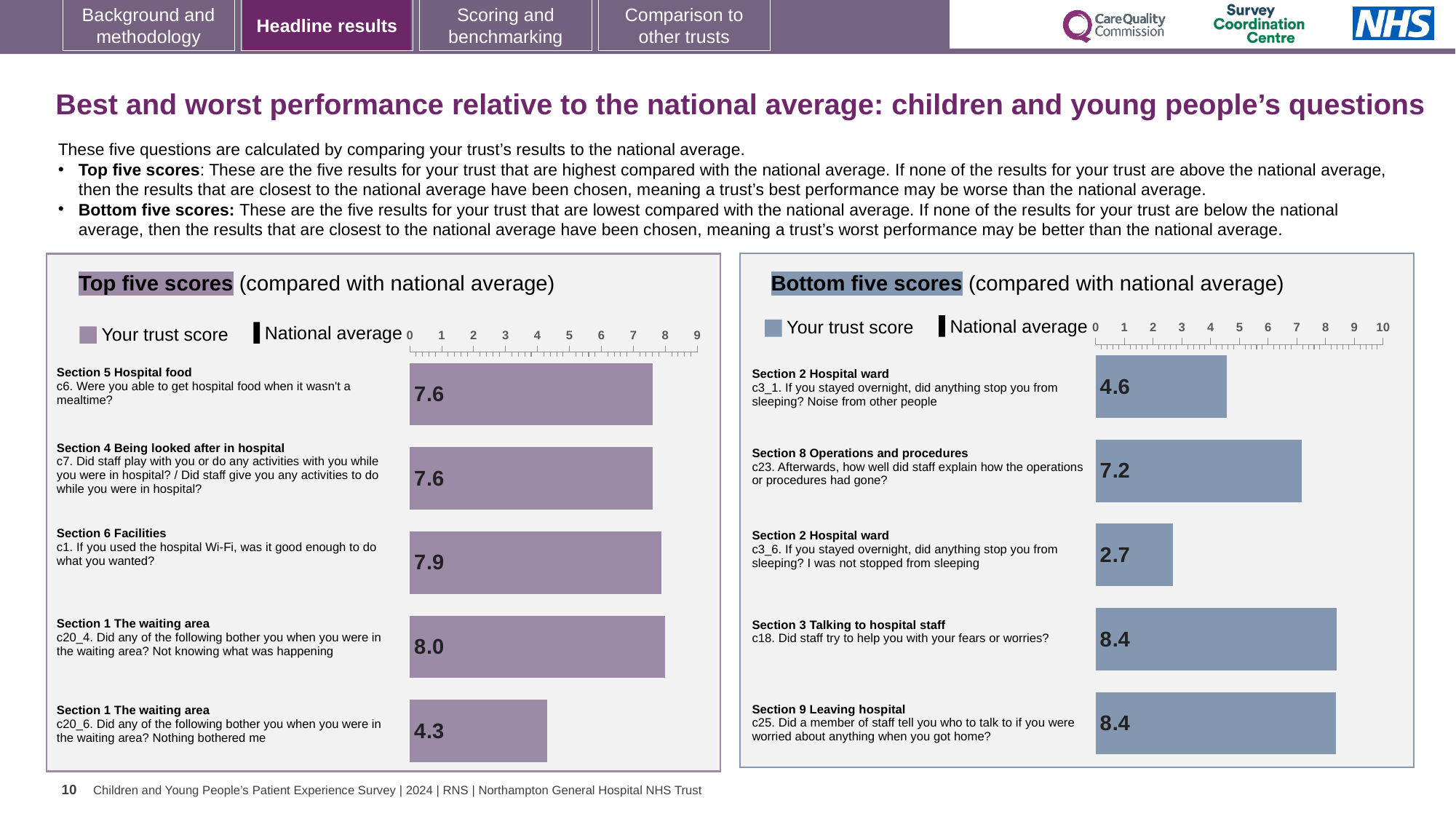
What type of chart is the Top five scores chart? Bar chart In the Top five scores chart, which question has the lowest trust score? c20_6. Did any of the following bother you when you were in the waiting area? Nothing bothered me In the Bottom five scores chart, which question has the lowest trust score? c3_6. If you stayed overnight, did anything stop you from sleeping? I was not stopped from sleeping In the Top five scores chart, what is the difference between the trust score for c20_4 and the trust score for c20_6? 3.7 In the Top five scores chart, what is the trust score for c1 (If you used the hospital Wi-Fi, was it good enough to do what you wanted?)? 7.9 In the Top five scores chart, what is the trust score for c6 (Were you able to get hospital food when it wasn't a mealtime?)? 7.6 In the Bottom five scores chart, what is the difference between the trust score for c18 and the trust score for c3_1? 3.8 How many questions are shown in the Bottom five scores chart? 5 In the Top five scores chart, which question has the highest trust score? c20_4. Did any of the following bother you when you were in the waiting area? Not knowing what was happening In the Bottom five scores chart, what is the trust score for c23 (Afterwards, how well did staff explain how the operations or procedures had gone?)? 7.2 In the Bottom five scores chart, which is larger: the trust score for c3_1 or the trust score for c23? c23 How many entries does the legend of the Top five scores chart list? 2